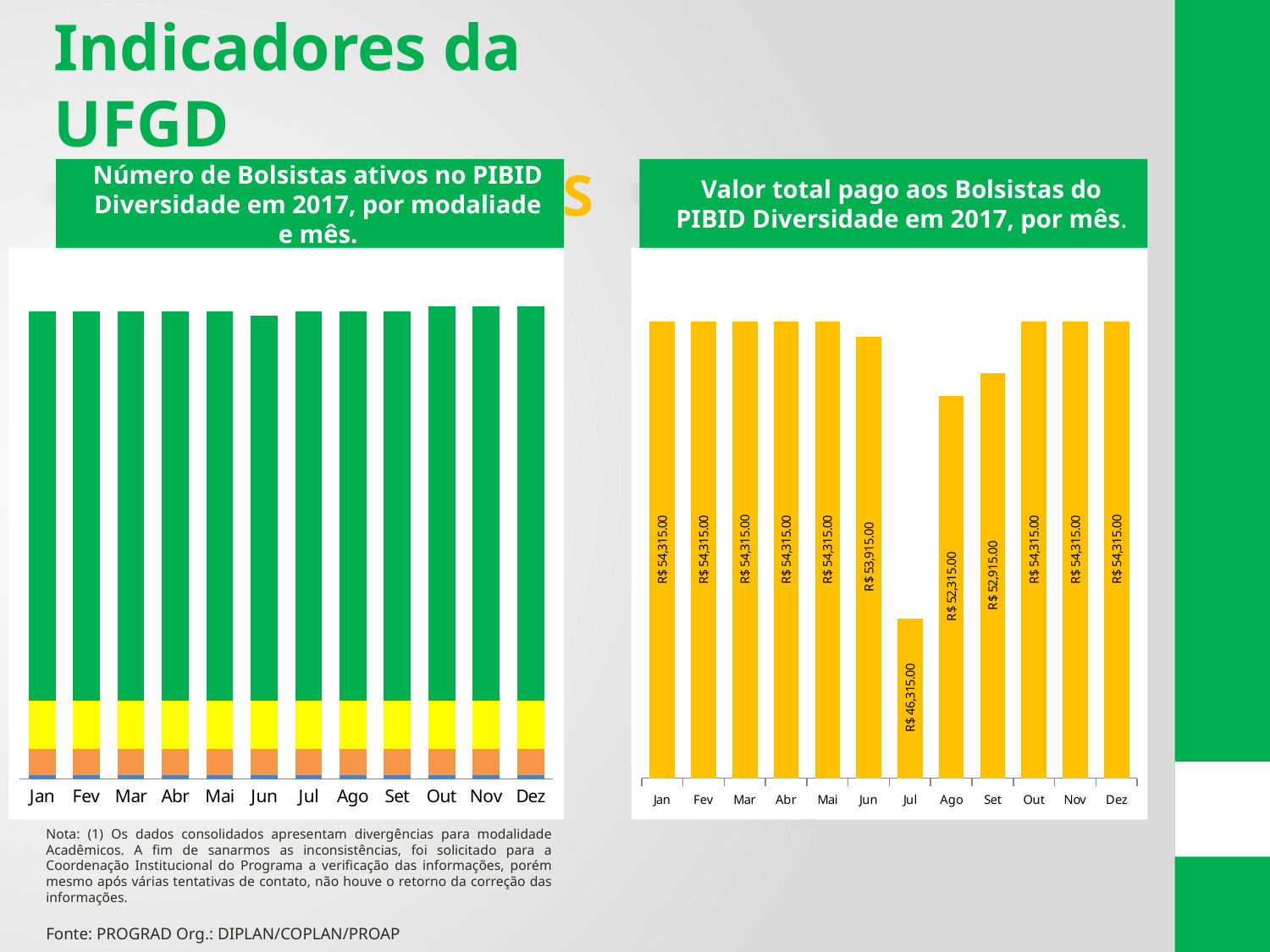
In the chart 'Valor total pago aos Bolsistas do PIBID Diversidade em 2017, por mês', what is the value for Jul? R$ 46,315.00 In the chart 'Valor total pago aos Bolsistas do PIBID Diversidade em 2017, por mês', what is the difference between the values for Set and Ago? R$ 600.00 In the chart 'Valor total pago aos Bolsistas do PIBID Diversidade em 2017, por mês', what is the difference between the values for Jan and Jul? R$ 8,000.00 In the chart 'Valor total pago aos Bolsistas do PIBID Diversidade em 2017, por mês', which is larger, the value for Ago or the value for Set? Set In the chart on the left, 'Número de Bolsistas ativos no PIBID Diversidade em 2017, por modaliade e mês', how many months are shown on the x axis? 12 What kind of chart is the chart on the left, 'Número de Bolsistas ativos no PIBID Diversidade em 2017, por modaliade e mês'? Stacked bar chart In the chart 'Valor total pago aos Bolsistas do PIBID Diversidade em 2017, por mês', what is the value for Jun? R$ 53,915.00 In the chart 'Valor total pago aos Bolsistas do PIBID Diversidade em 2017, por mês', what is the value for Set? R$ 52,915.00 In the chart 'Valor total pago aos Bolsistas do PIBID Diversidade em 2017, por mês', which month has the lowest value? Jul In the chart 'Valor total pago aos Bolsistas do PIBID Diversidade em 2017, por mês', what is the value for Ago? R$ 52,315.00 In the chart 'Valor total pago aos Bolsistas do PIBID Diversidade em 2017, por mês', how many months are shown on the x axis? 12 What kind of chart is the chart 'Valor total pago aos Bolsistas do PIBID Diversidade em 2017, por mês'? Bar chart